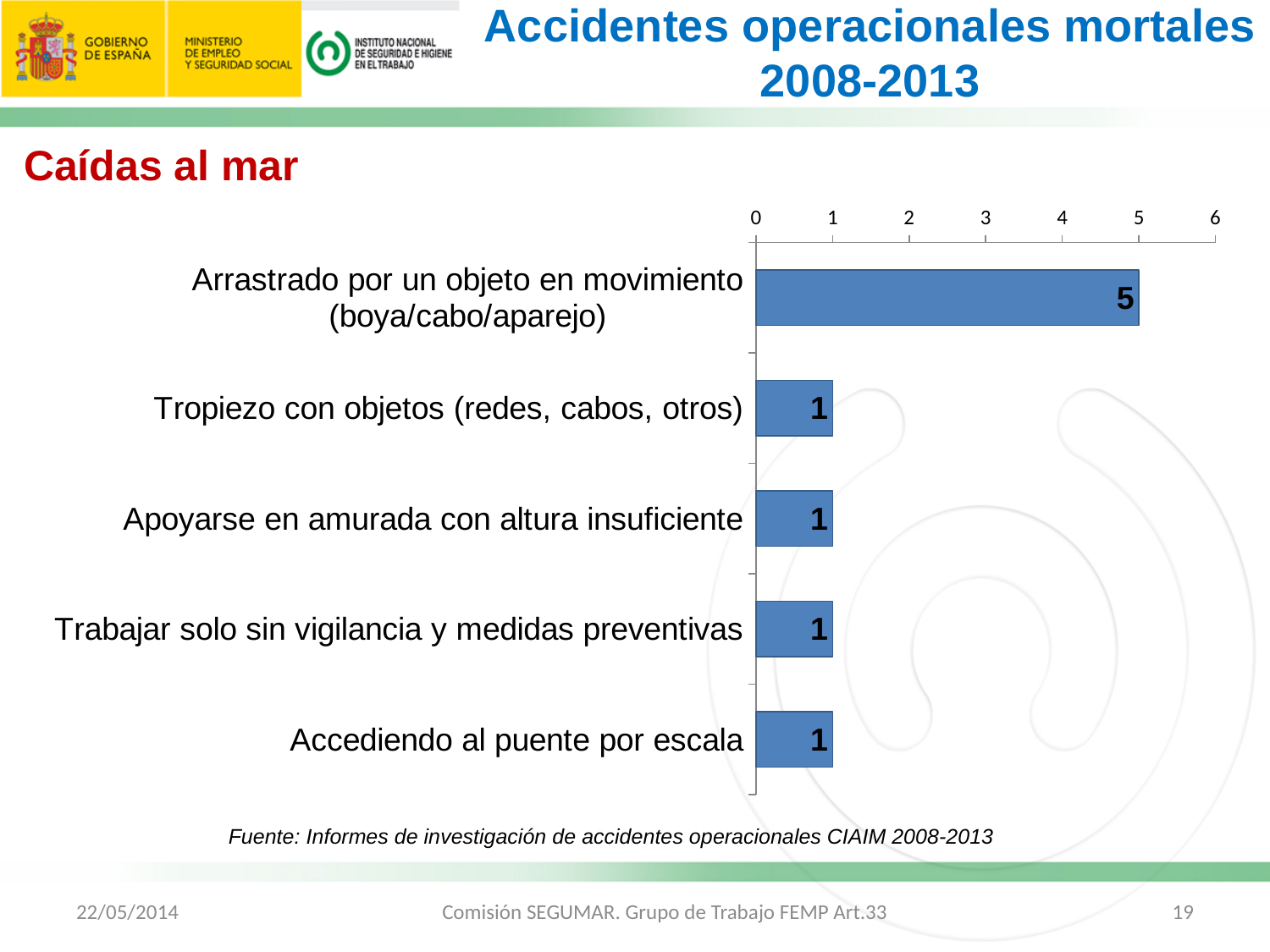
What is the heading above the chart? Caídas al mar What is the highest value shown on the chart's axis? 6 What is the difference between the value for "Arrastrado por un objeto en movimiento (boya/cabo/aparejo)" and the value for "Apoyarse en amurada con altura insuficiente"? 4 What kind of chart is shown on the slide? bar chart What is the total of all the values shown in the chart? 9 What is the value for "Arrastrado por un objeto en movimiento (boya/cabo/aparejo)"? 5 Which is larger: the value for "Arrastrado por un objeto en movimiento (boya/cabo/aparejo)" or the value for "Trabajar solo sin vigilancia y medidas preventivas"? Arrastrado por un objeto en movimiento (boya/cabo/aparejo) How many categories are shown in the chart? 5 Is the value for "Arrastrado por un objeto en movimiento (boya/cabo/aparejo)" greater or less than 3? greater What is the value for "Tropiezo con objetos (redes, cabos, otros)"? 1 Which category has the highest value? Arrastrado por un objeto en movimiento (boya/cabo/aparejo) What is the value for "Accediendo al puente por escala"? 1